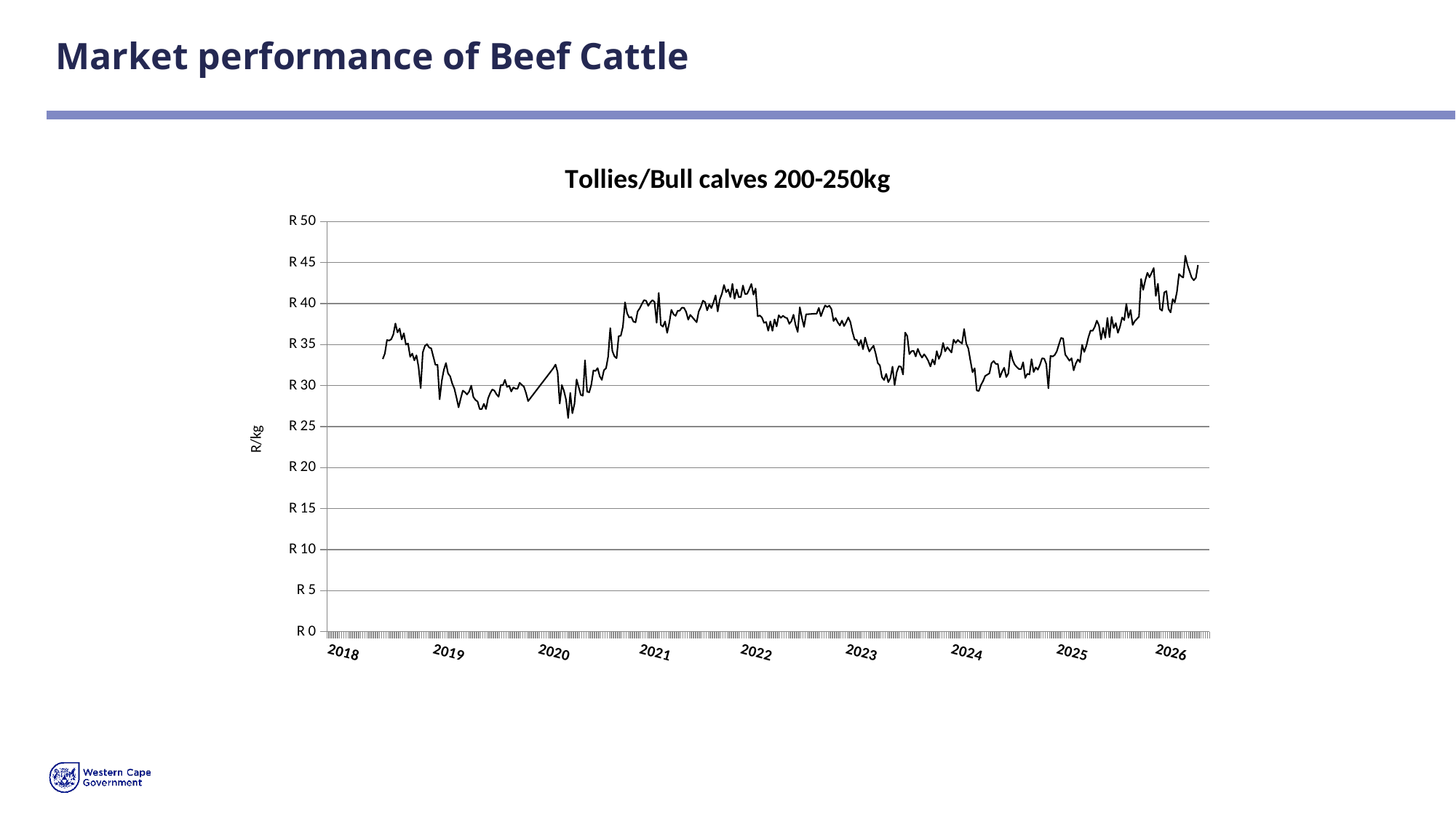
How many year labels are shown along the x axis? 9 What kind of chart is shown on the slide? line chart In which year does the line reach its highest value? 2026 Do the values rise or fall between 2024 and 2026? rise Is the value at the start of 2022 greater or less than R 40? greater What is the label on the vertical axis of the chart? R/kg Do the values rise or fall between 2022 and 2023? fall Is the value at the end of the line in 2026 greater or less than R 40? greater What is the title of the chart? Tollies/Bull calves 200-250kg